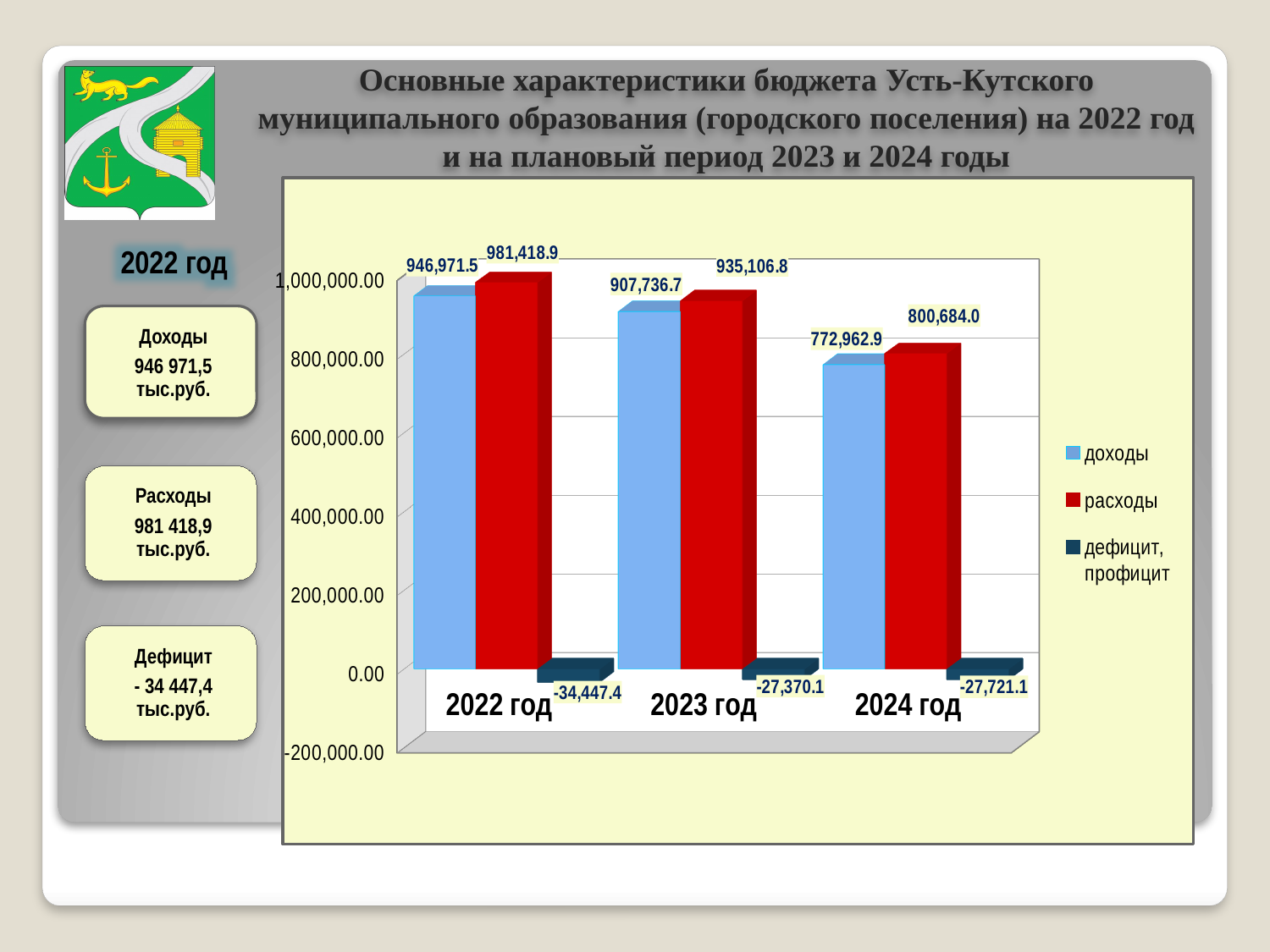
What is the value of доходы for 2022 год? 946,971.5 How many years (categories) are shown on the x axis? 3 Which is larger: доходы for 2023 год or расходы for 2024 год? доходы for 2023 год What is the difference between доходы for 2022 год and доходы for 2024 год? 174,008.6 What kind of chart is shown on the slide? bar chart What is the difference between расходы and доходы for 2022 год? 34,447.4 Which year has the lowest value of доходы? 2024 год Do the values of доходы rise or fall from 2022 год to 2024 год? fall How many series does the legend list? 3 What is the value of дефицит, профицит for 2023 год? -27,370.1 Which year has the highest value of расходы? 2022 год What is the value of расходы for 2024 год? 800,684.0